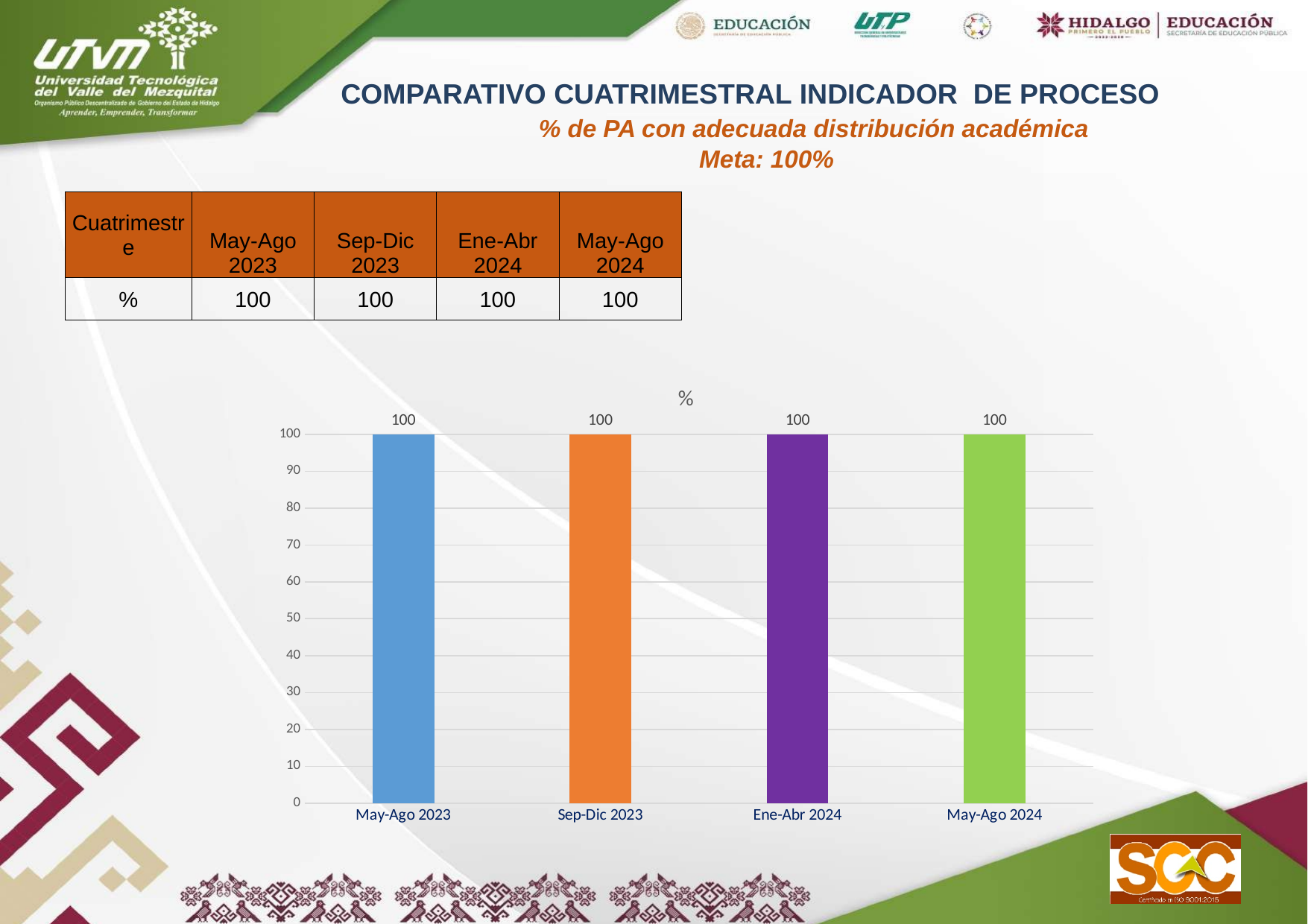
What is the value for May-Ago 2023 in the chart? 100 What is the value for Ene-Abr 2024 in the chart? 100 What is the title of the chart? % What is the difference between the values for May-Ago 2024 and May-Ago 2023? 0 What kind of chart is shown on the slide? bar chart What colour is the bar for Ene-Abr 2024? purple What is the highest tick value shown on the y axis of the chart? 100 Do the values rise, fall, or stay the same from May-Ago 2023 to May-Ago 2024? stay the same What is the value for Sep-Dic 2023 in the chart? 100 What is the value for May-Ago 2024 in the chart? 100 Is the value for Ene-Abr 2024 greater or less than 50? greater How many categories are shown on the x axis of the chart? 4